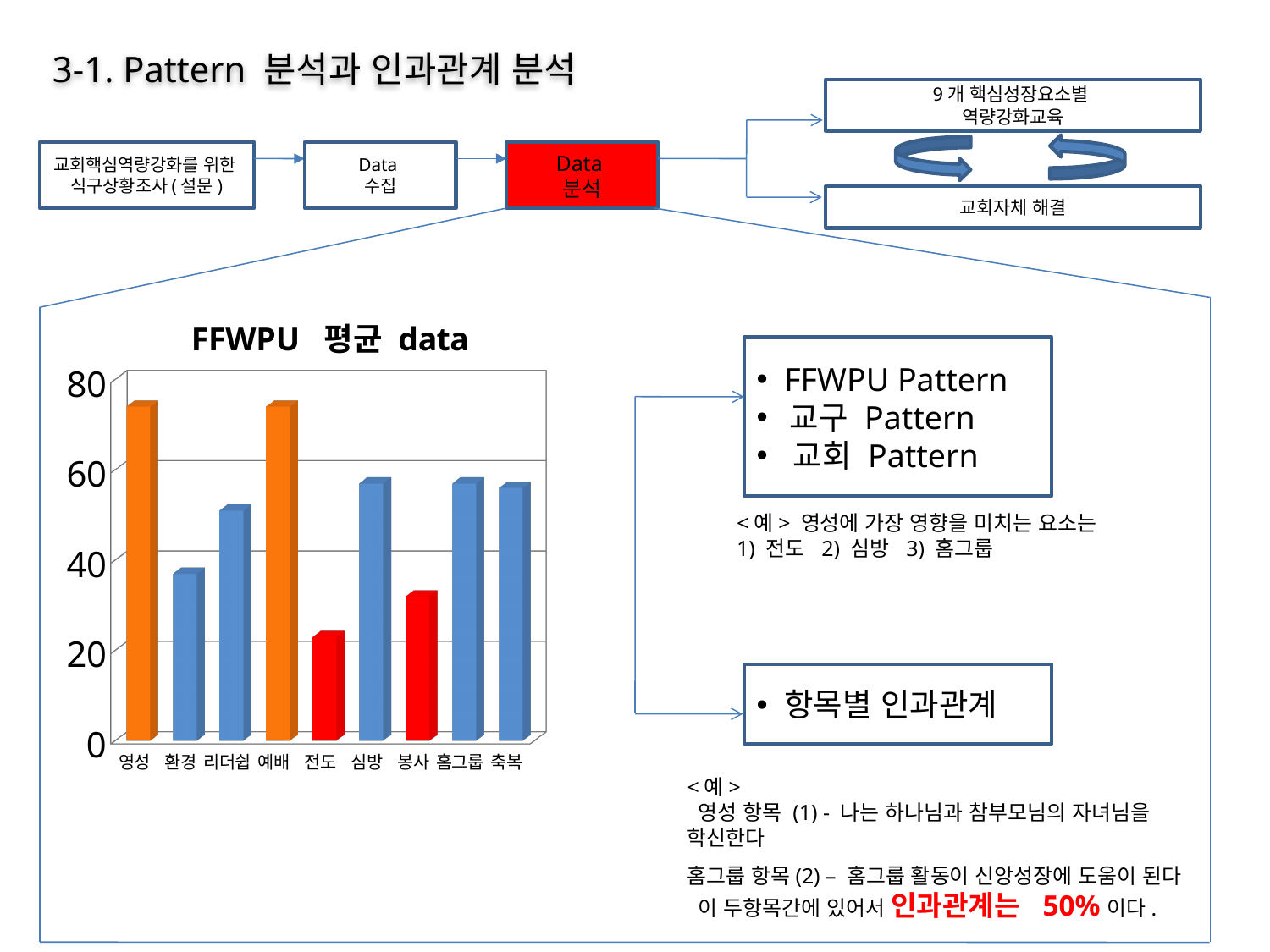
Is the value for 봉사 greater or less than 40? less Which is larger, the value for 전도 or the value for 봉사? 봉사 What kind of chart is the "FFWPU 평균 data" chart? bar chart Which is larger, the value for 영성 or the value for 환경? 영성 How many categories are shown on the x axis of the "FFWPU 평균 data" chart? 9 Is the value for 전도 greater or less than 40? less Which is larger, the value for 환경 or the value for 리더쉽? 리더쉽 Is the value for 영성 greater or less than 60? greater What is the title of the bar chart on the slide? FFWPU 평균 data Which category has the lowest value in the "FFWPU 평균 data" chart? 전도